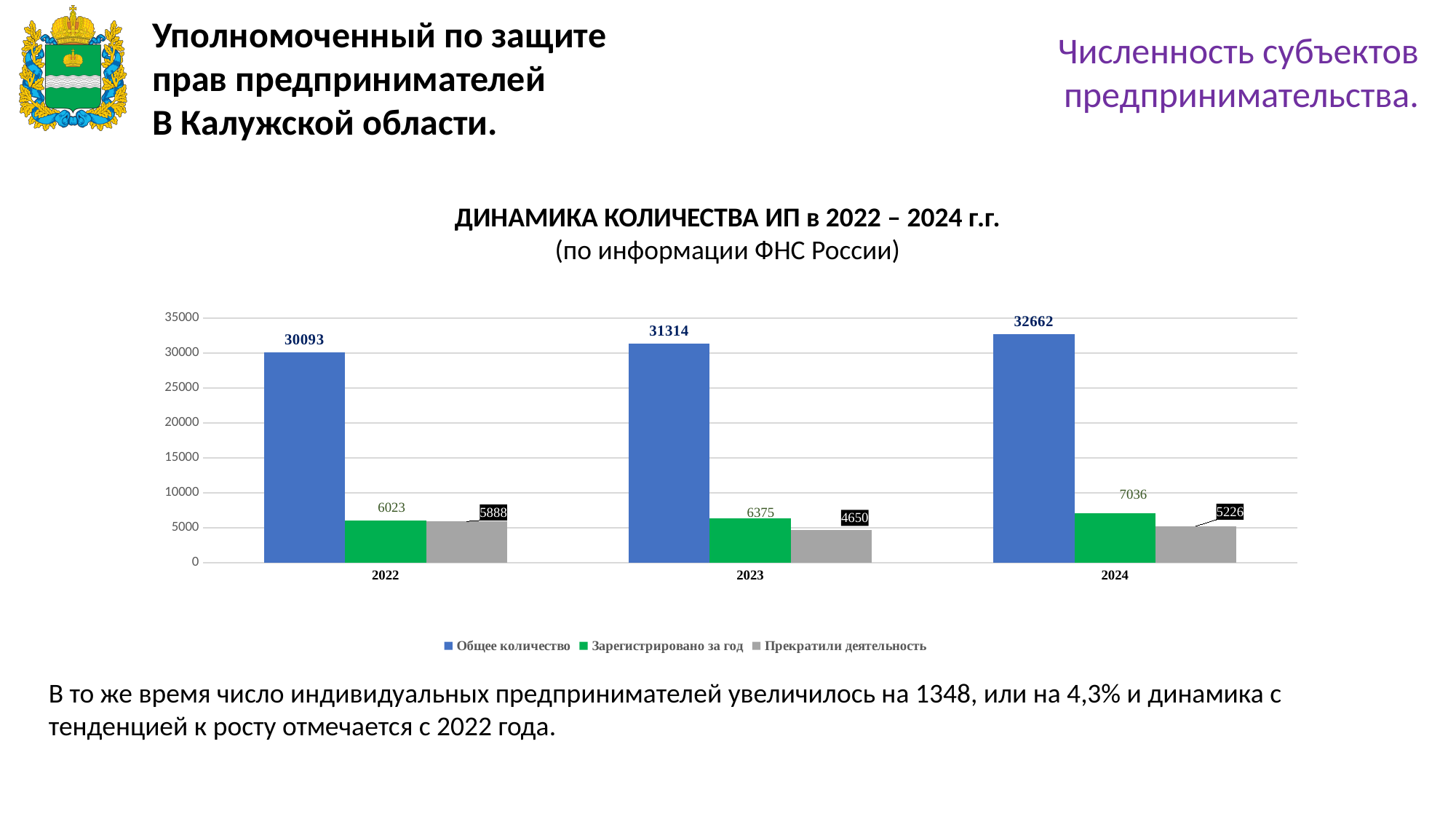
Is the value of "Общее количество" for 2023 greater or less than 30000? greater What is the value of "Прекратили деятельность" for 2023? 4650 What is the value of "Зарегистрировано за год" for 2022? 6023 What kind of chart is shown? bar chart In which year is "Прекратили деятельность" lowest? 2023 Does "Зарегистрировано за год" rise or fall from 2022 to 2024? rise Which is larger in 2022: "Зарегистрировано за год" or "Прекратили деятельность"? Зарегистрировано за год What is the difference between "Общее количество" in 2024 and in 2022? 2569 In which year is "Общее количество" highest? 2024 What is the value of "Общее количество" for 2024? 32662 How many series does the legend list? 3 How many years are shown on the x axis? 3